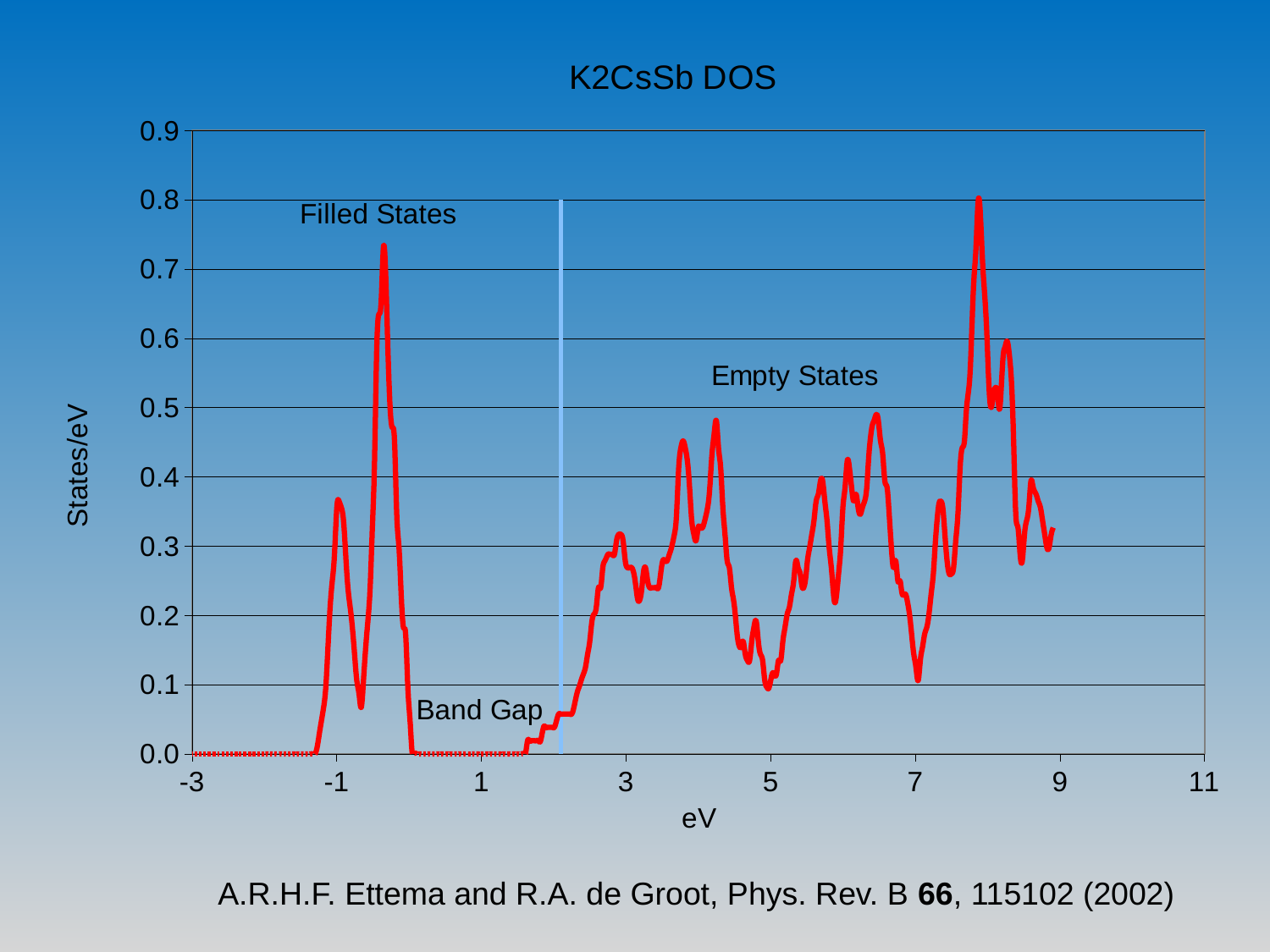
What is the title of the chart? K2CsSb DOS Is the value of the curve at -3 eV greater or less than 0.1 States/eV? less Is the peak near -1 eV greater or less than 0.4 States/eV? less Does the curve rise or fall between 1 eV and 3 eV? rise Is the tallest peak in the Filled States region greater or less than 0.6 States/eV? greater Which region contains the highest peak of the curve, Filled States or Empty States? Empty States What is the label of the vertical axis? States/eV What kind of chart is shown on the slide? line chart